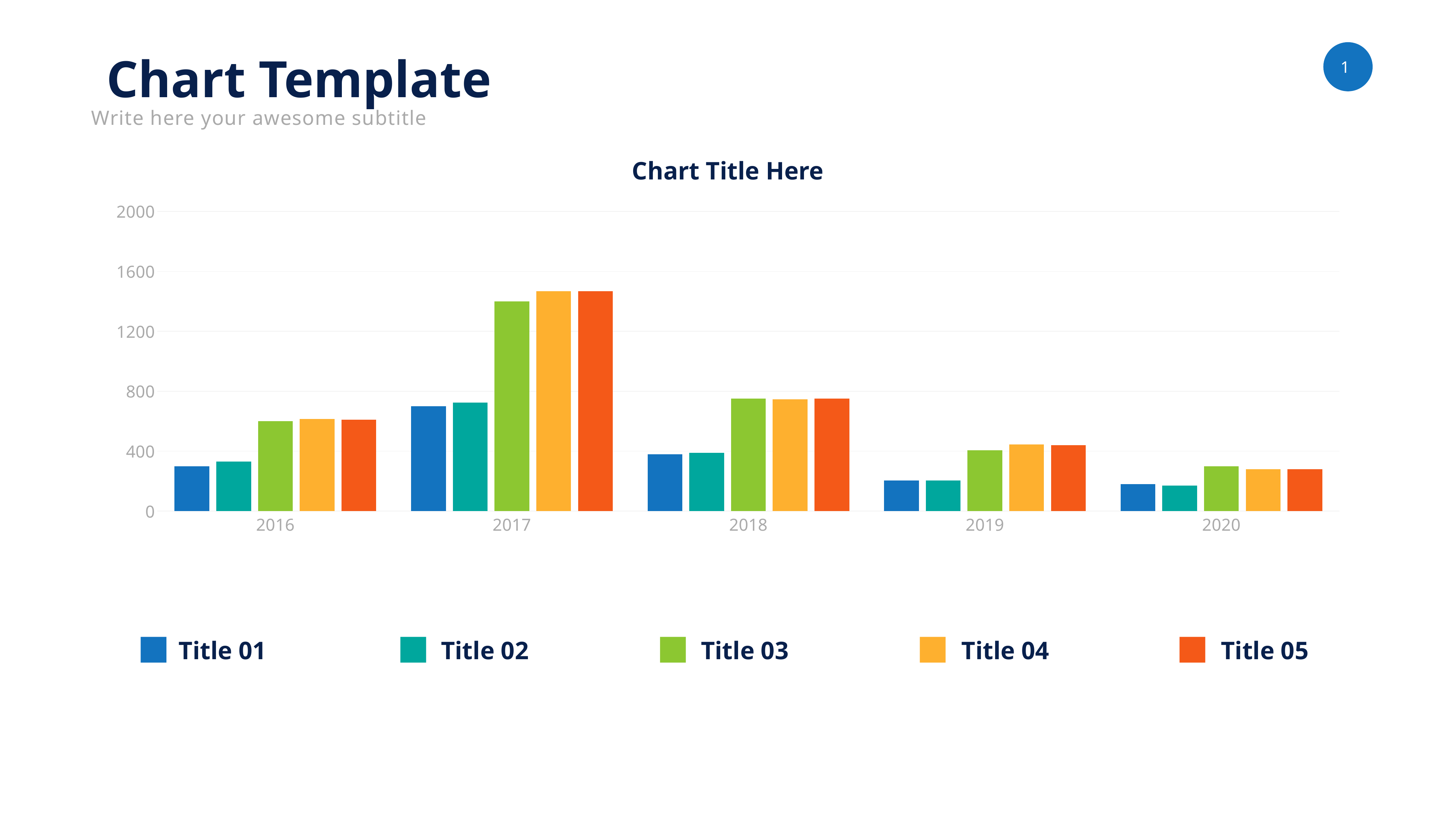
How many series does the chart legend list? 5 In which year is the Title 03 bar the lowest? 2020 Is the value for Title 04 in 2018 greater or less than 800? less Is the value for Title 01 in 2016 greater or less than 400? less What is the title of the chart? Chart Title Here How many years are shown along the x axis of the chart? 5 Do the Title 01 values rise or fall from 2017 to 2020? fall Is the value for Title 03 in 2017 greater or less than 1200? greater In 2018, which is larger: the value for Title 01 or the value for Title 03? Title 03 What kind of chart is shown on the slide? bar chart In which year is the Title 01 bar the highest? 2017